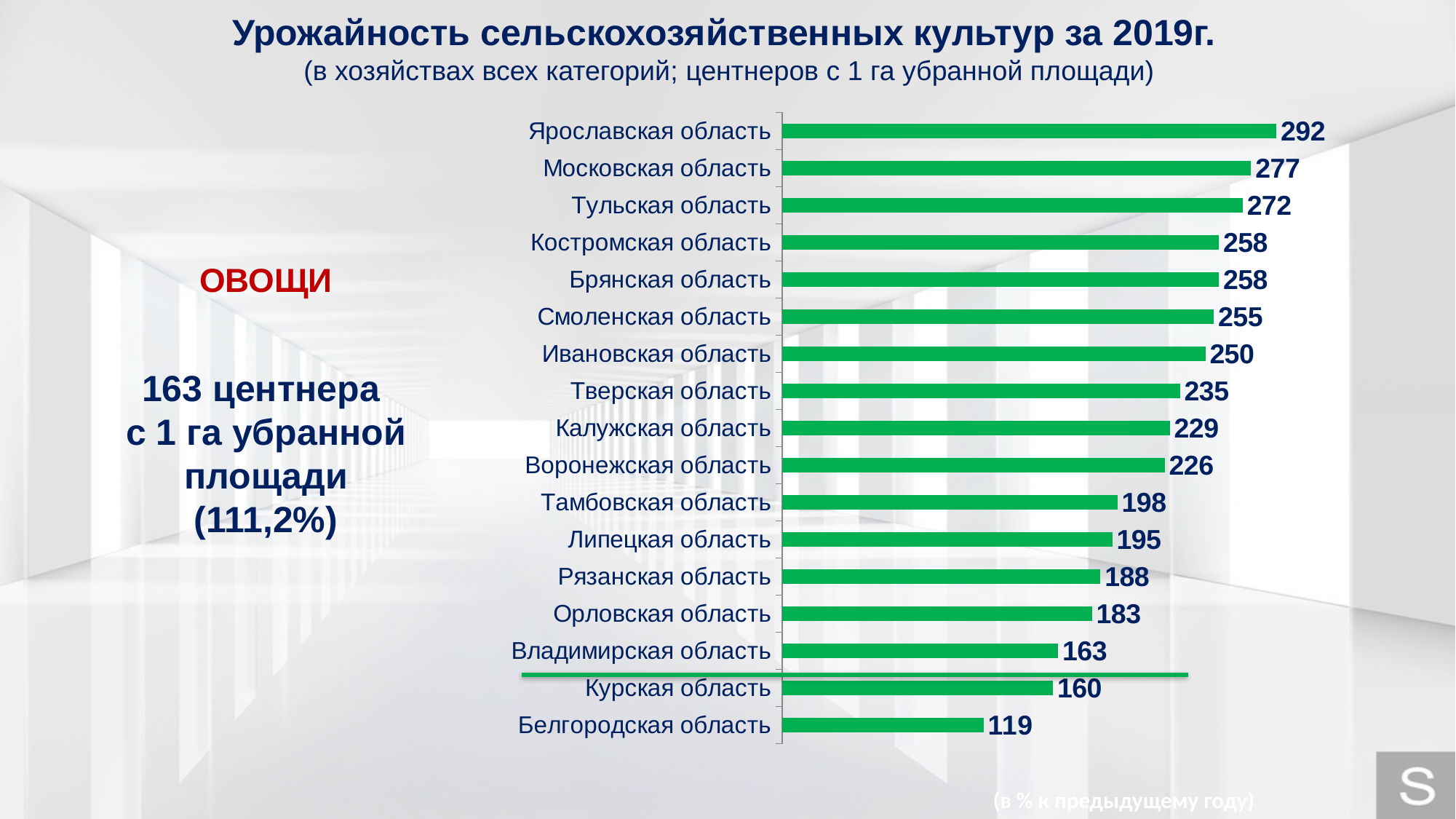
What is the value for Белгородская область? 119 What is the value for Владимирская область? 163 What is the difference between the values for Курская область and Белгородская область? 41 Which is larger, the value for Тульская область or the value for Ивановская область? Тульская область How many regions are shown in the chart? 17 Which region has the highest value? Ярославская область What colour are the bars in the chart? green What kind of chart is shown on the slide? bar chart What is the value for Ярославская область? 292 What is the difference between the values for Ярославская область and Московская область? 15 Which region has the lowest value? Белгородская область What is the value for Тверская область? 235